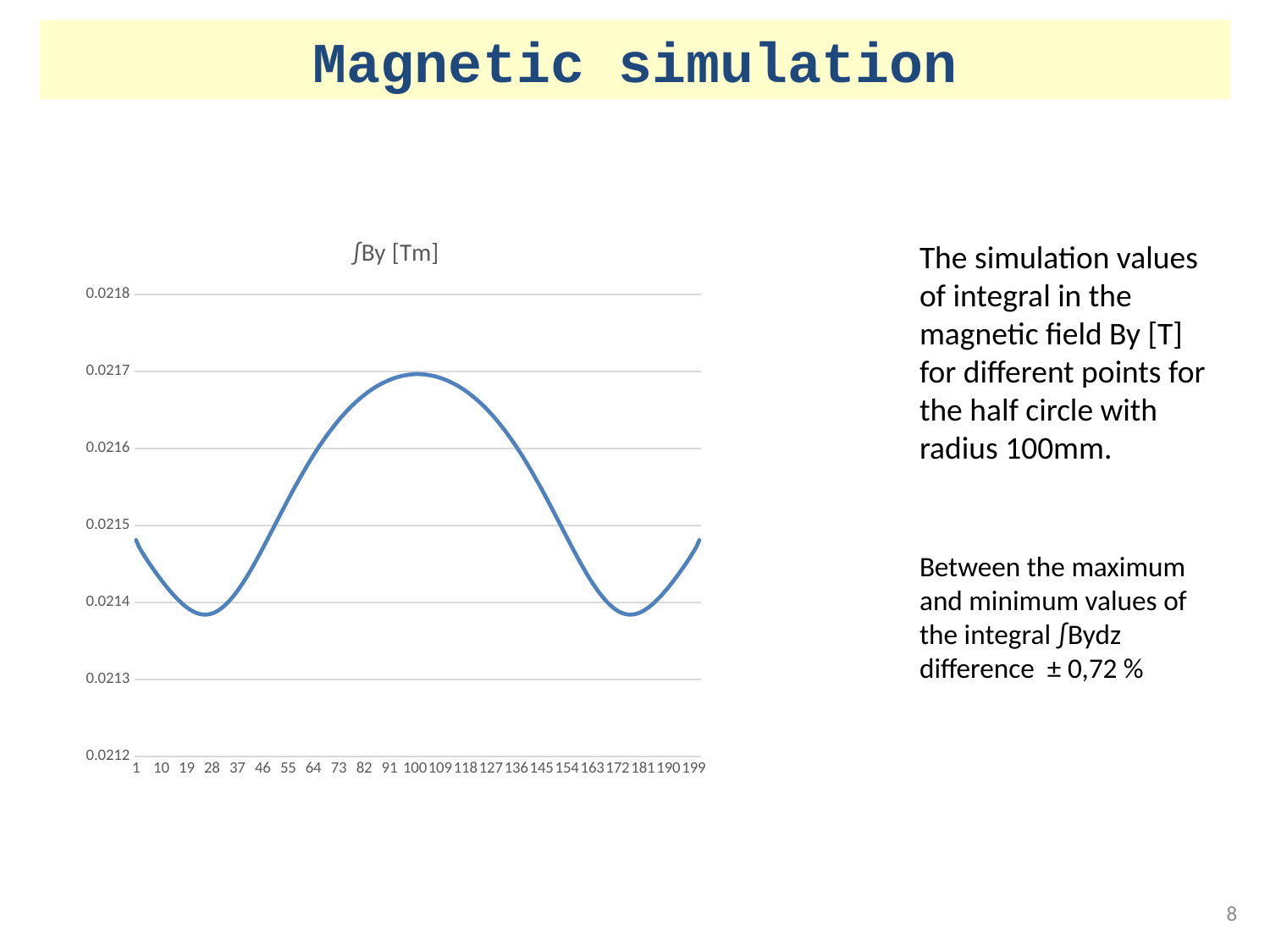
What is the last label on the x axis? 199 Is the value at x = 1 greater or less than 0.0214? greater Is the value at x = 100 greater or less than 0.0216? greater Does the line rise or fall between x = 28 and x = 100? rise Does the line rise or fall between x = 100 and x = 172? fall What is the highest value shown on the y axis? 0.0218 Which is larger, the value at x = 100 or the value at x = 28? x = 100 Is the value at x = 28 greater or less than 0.0215? less What is the title of the chart? ∫By [Tm] Around which x-axis label does the line reach its highest value? 100 What kind of chart is shown on the slide? line chart